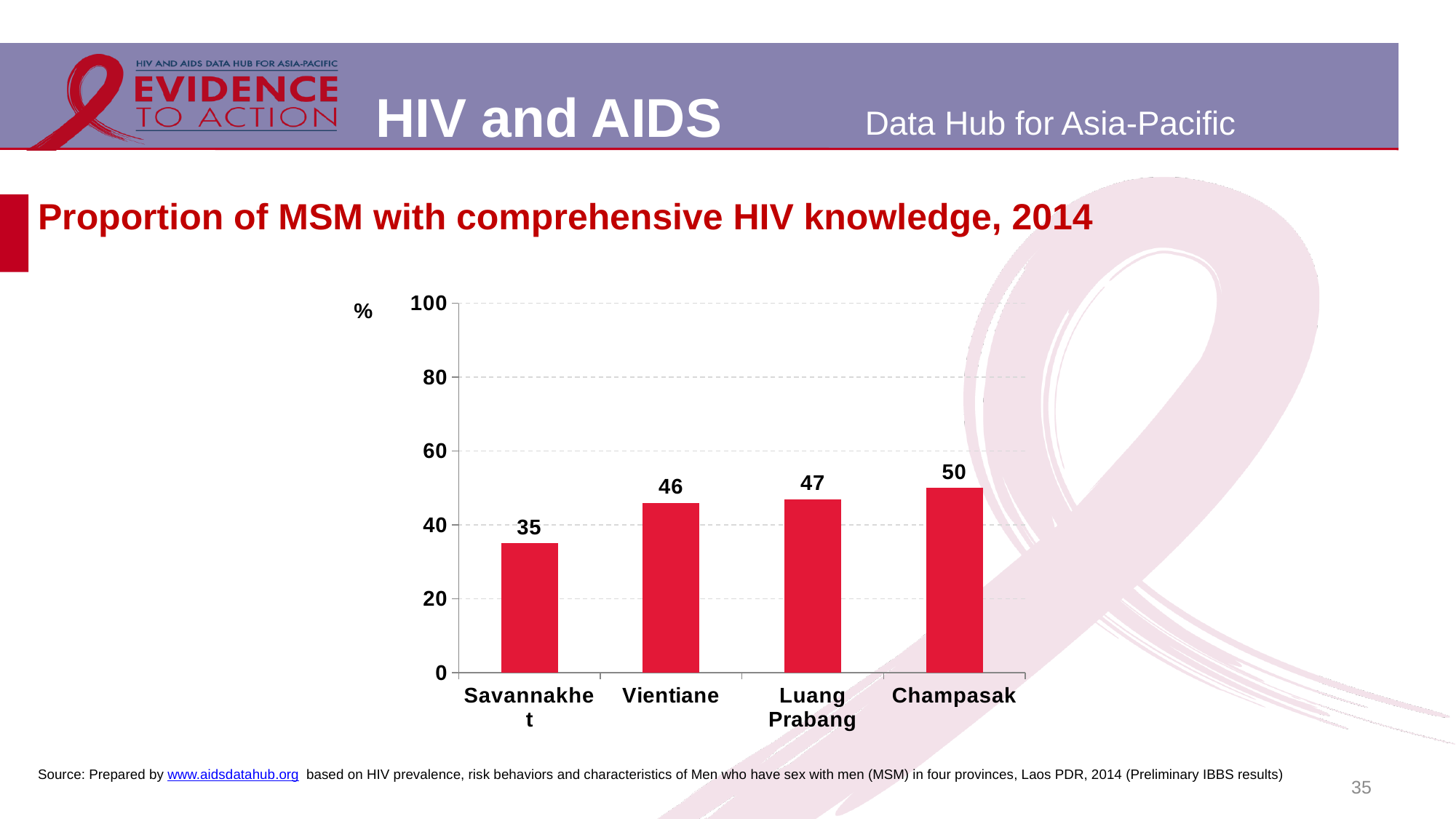
Which is larger, the value for Champasak or the value for Savannakhet? Champasak What is the value for Vientiane? 46 What is the value for Champasak? 50 What kind of chart is shown on the slide? Bar chart What is the difference between the values for Champasak and Savannakhet? 15 How many provinces are shown in the chart? 4 What is the difference between the values for Vientiane and Savannakhet? 11 What unit is shown on the vertical axis of the chart? % What is the value for Luang Prabang? 47 Which province has the lowest proportion of MSM with comprehensive HIV knowledge? Savannakhet What is the value for Savannakhet? 35 Which province has the highest proportion of MSM with comprehensive HIV knowledge? Champasak